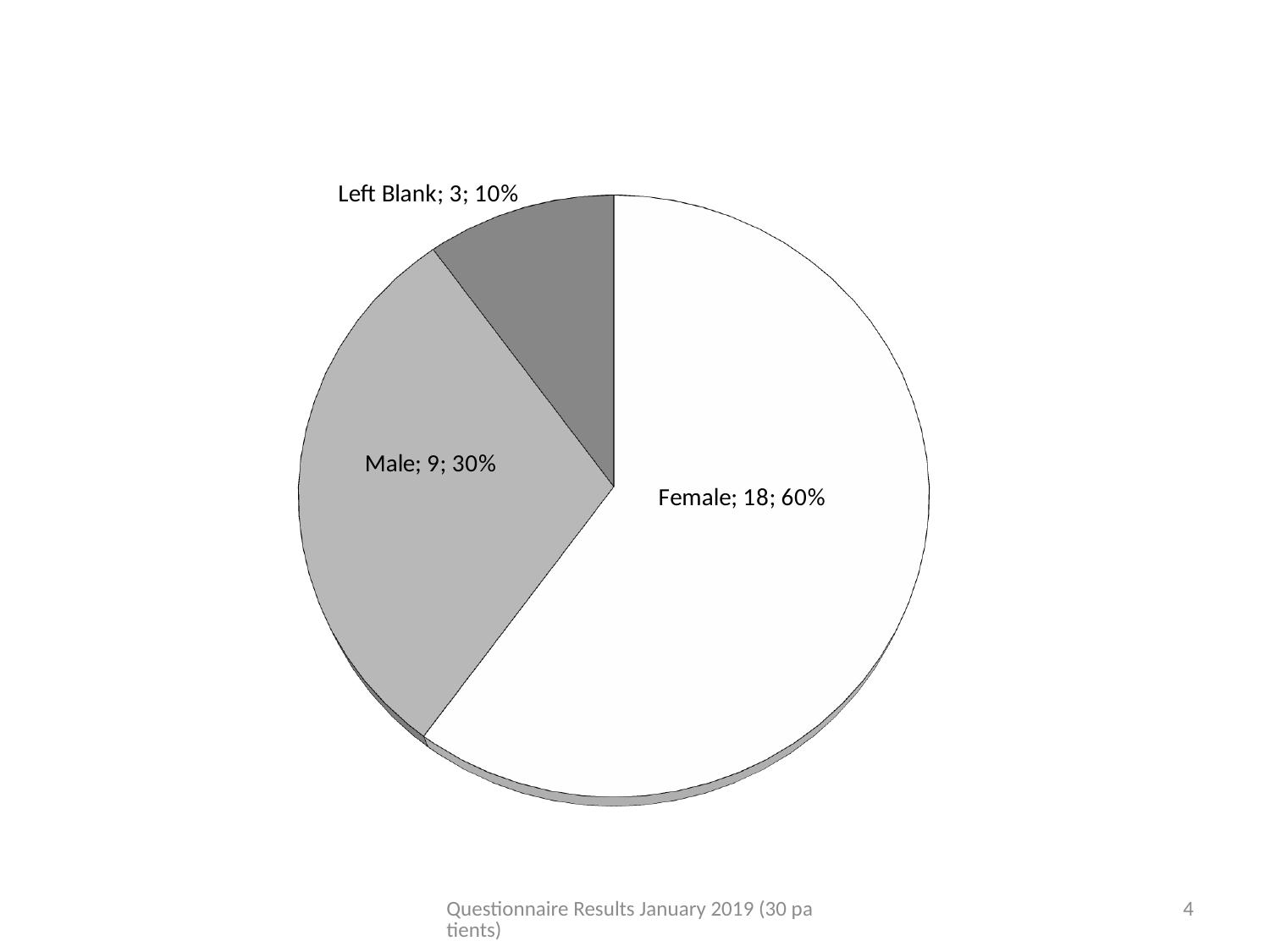
What share of the pie does the Left Blank slice represent? 10% Which is larger, the Male count or the Left Blank count? Male What is the count for Left Blank in the pie chart? 3 Which category has the smallest slice in the pie chart? Left Blank What is the difference between the Female count and the Male count? 9 Which category has the largest slice in the pie chart? Female What share of the pie does the Female slice represent? 60% What kind of chart is shown on the slide? pie chart What is the count for Male in the pie chart? 9 What share of the pie does the Male slice represent? 30% How many slices does the pie chart have? 3 What is the count for Female in the pie chart? 18